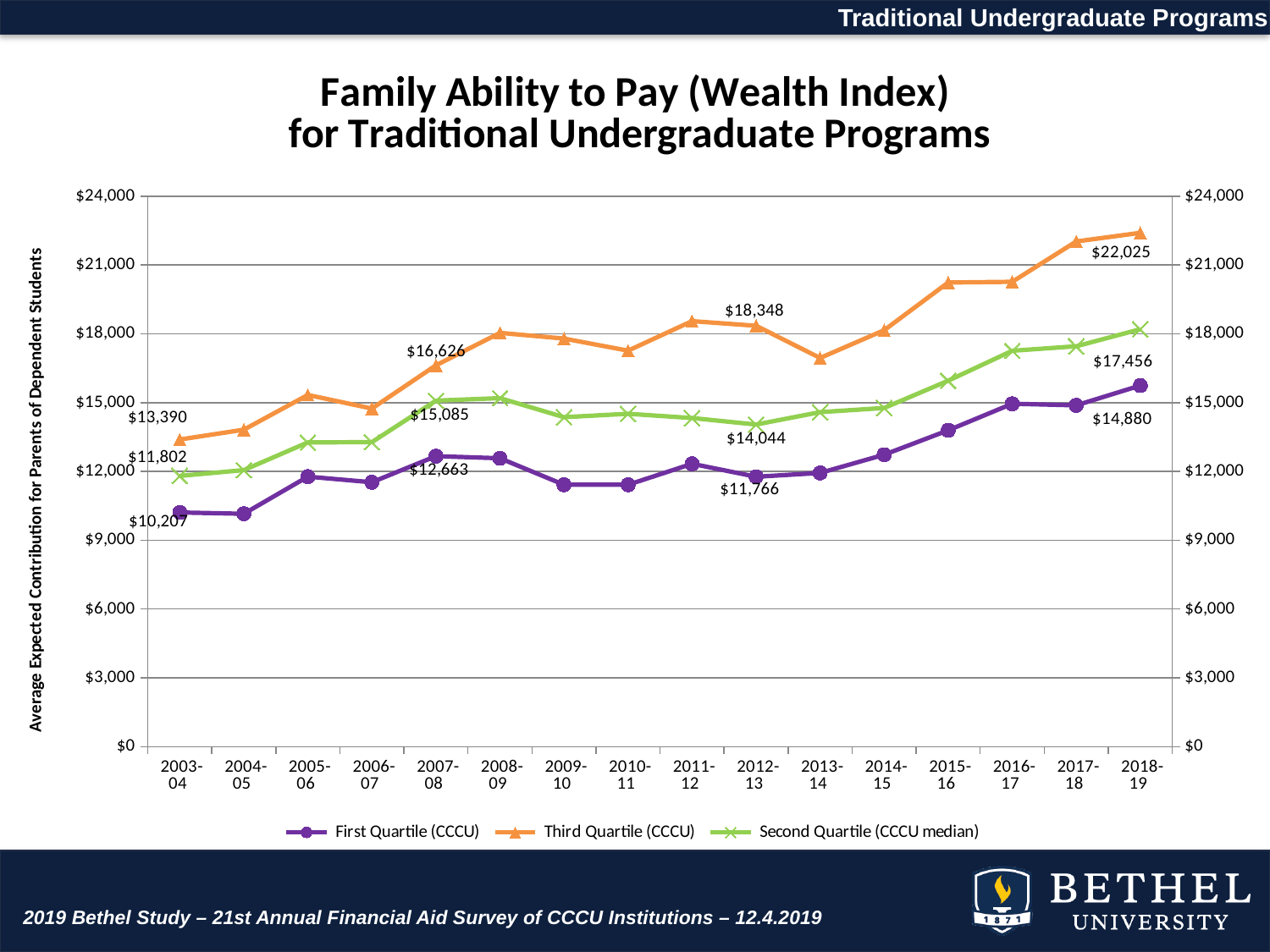
What type of chart is shown on the slide? line chart What is the value for Third Quartile (CCCU) in 2007-08? $16,626 Overall, do the Third Quartile (CCCU) values rise or fall from 2003-04 to 2018-19? rise Which is larger in 2012-13: the First Quartile (CCCU) value or the Second Quartile (CCCU median) value? Second Quartile (CCCU median) What is the value for Second Quartile (CCCU median) in 2012-13? $14,044 Is the value for Third Quartile (CCCU) in 2015-16 greater or less than $18,000? greater What is the value for First Quartile (CCCU) in 2003-04? $10,207 How many series does the legend list? 3 How many academic years are shown on the x axis? 16